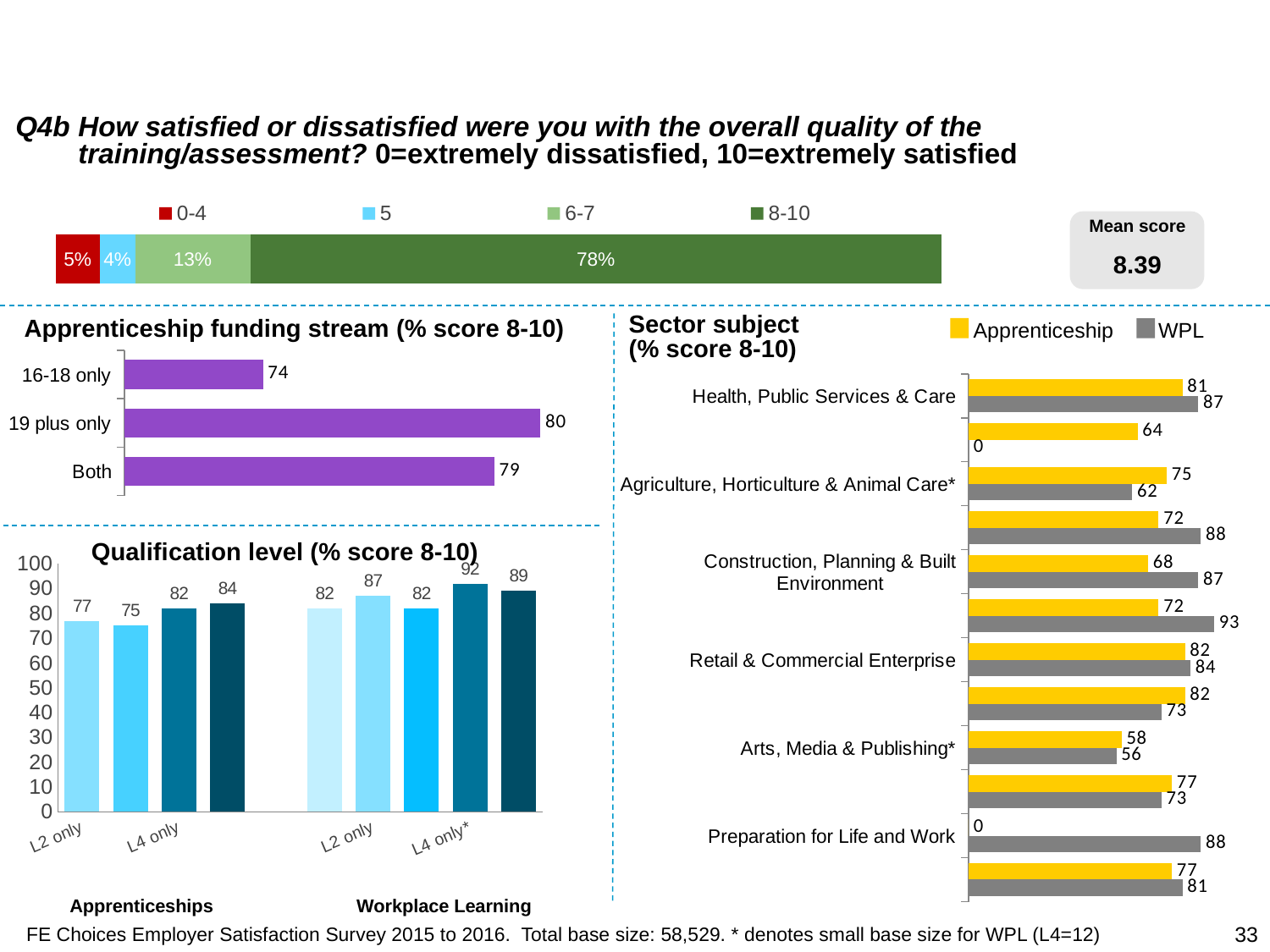
In the Apprenticeship funding stream chart, what is the difference between 19 plus only and 16-18 only? 6 In the top stacked bar chart, what percentage of respondents gave a score of 0-4? 5% In the Apprenticeship funding stream chart, which category has the lowest value? 16-18 only In the Sector subject chart, what is the WPL value for Construction, Planning & Built Environment? 87 In the Sector subject chart, which is larger for Agriculture, Horticulture & Animal Care*: Apprenticeship or WPL? Apprenticeship What type of chart is the Apprenticeship funding stream chart? Bar chart In the top stacked bar chart, how many score bands does the legend list? 4 In the Apprenticeship funding stream chart, what is the value for 19 plus only? 80 In the Sector subject chart, what is the difference between the WPL and Apprenticeship values for Health, Public Services & Care? 6 What is the mean score shown on the slide? 8.39 In the top stacked bar chart, what percentage of respondents gave a score of 8-10? 78% In the Qualification level chart, what is the highest value shown? 92